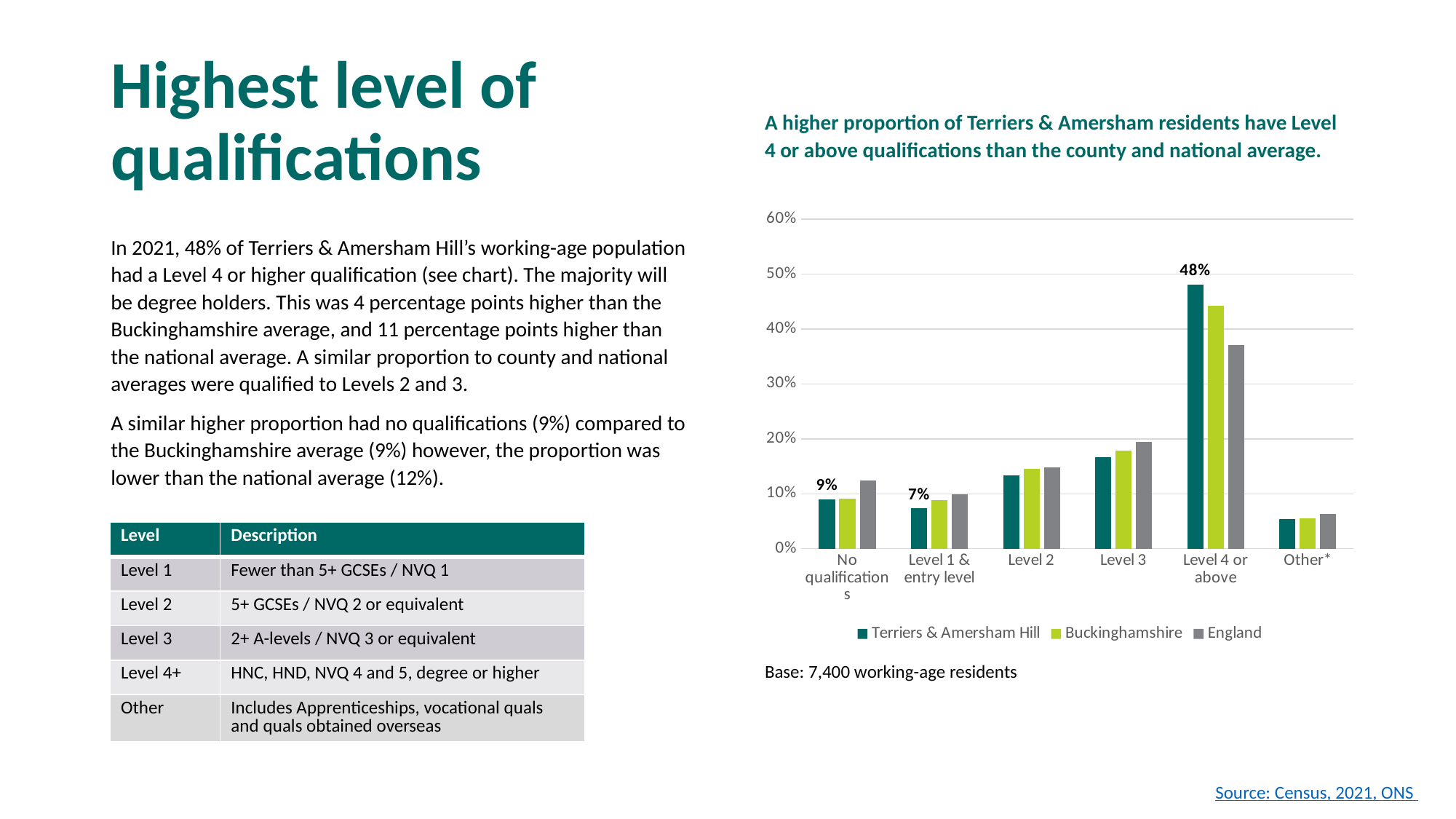
Is the value for England in the No qualifications category greater or less than 10%? greater What is the value for Terriers & Amersham Hill in the Level 1 & entry level category? 7% What is the difference between the Terriers & Amersham Hill values for Level 4 or above and No qualifications? 39 percentage points Is the value for England in the Level 4 or above category greater or less than 30%? greater In the Level 4 or above category, which is larger: Terriers & Amersham Hill or England? Terriers & Amersham Hill How many qualification categories are shown on the x axis of the chart? 6 What kind of chart is shown on the slide? Bar chart What is the value for Terriers & Amersham Hill in the Level 4 or above category? 48% What is the value for Terriers & Amersham Hill in the No qualifications category? 9% Which category has the highest value for Terriers & Amersham Hill? Level 4 or above How many series does the chart's legend list? 3 Which category has the lowest value for Terriers & Amersham Hill? Other*